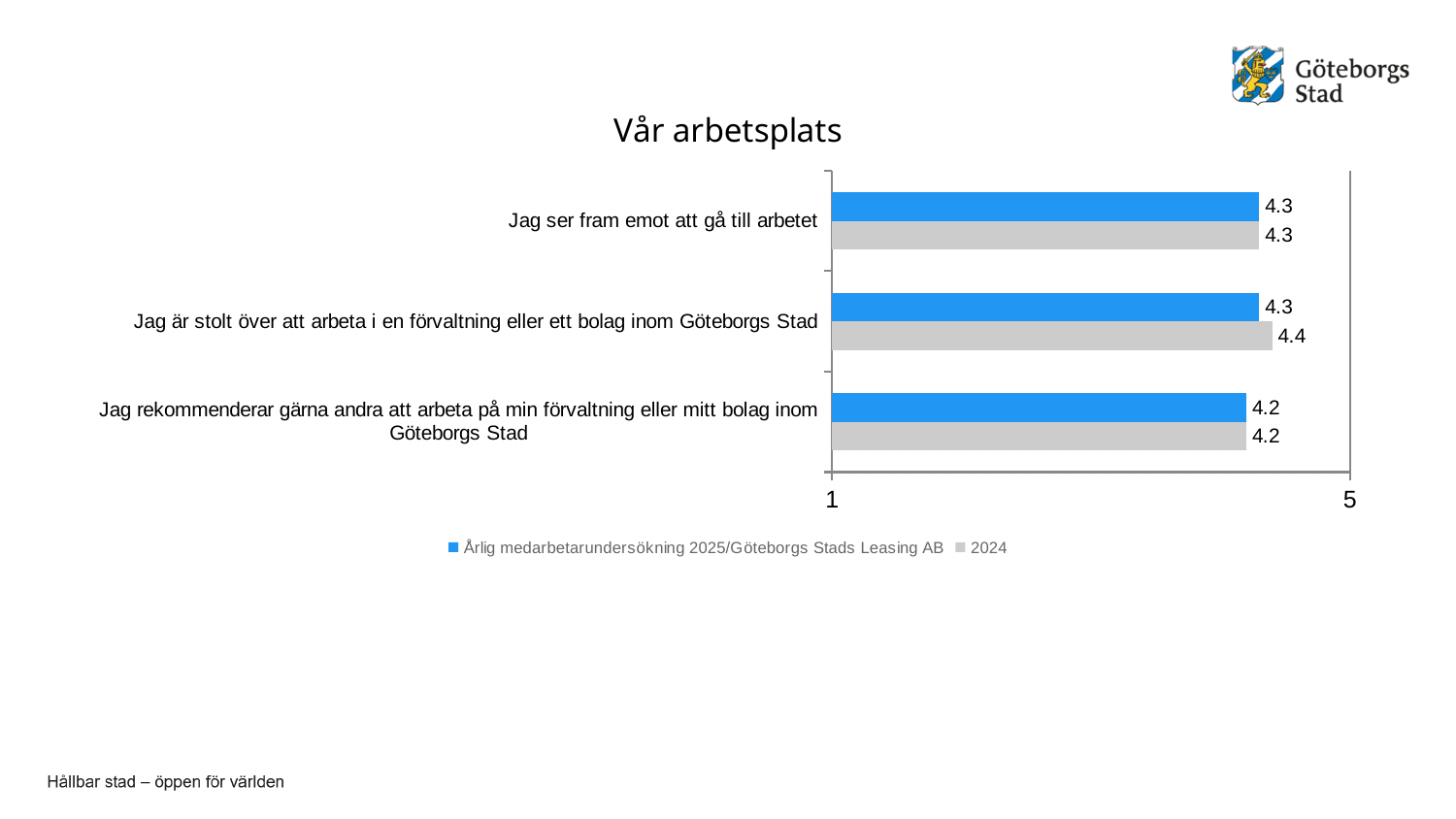
How many series does the legend list? 2 How many categories (statements) are shown in the chart? 3 What is the 2024 value for "Jag ser fram emot att gå till arbetet"? 4.3 What is the 2024 value for "Jag är stolt över att arbeta i en förvaltning eller ett bolag inom Göteborgs Stad"? 4.4 Which statement has the lowest 2025 value? Jag rekommenderar gärna andra att arbeta på min förvaltning eller mitt bolag inom Göteborgs Stad What is the 2025 value for "Jag rekommenderar gärna andra att arbeta på min förvaltning eller mitt bolag inom Göteborgs Stad"? 4.2 What is the title of the chart? Vår arbetsplats Which series is shown in blue? Årlig medarbetarundersökning 2025/Göteborgs Stads Leasing AB What is the difference between the 2024 and 2025 values for "Jag är stolt över att arbeta i en förvaltning eller ett bolag inom Göteborgs Stad"? 0.1 Which statement has the highest 2024 value? Jag är stolt över att arbeta i en förvaltning eller ett bolag inom Göteborgs Stad What kind of chart is shown on the slide? bar chart What is the 2025 (Årlig medarbetarundersökning 2025/Göteborgs Stads Leasing AB) value for "Jag ser fram emot att gå till arbetet"? 4.3